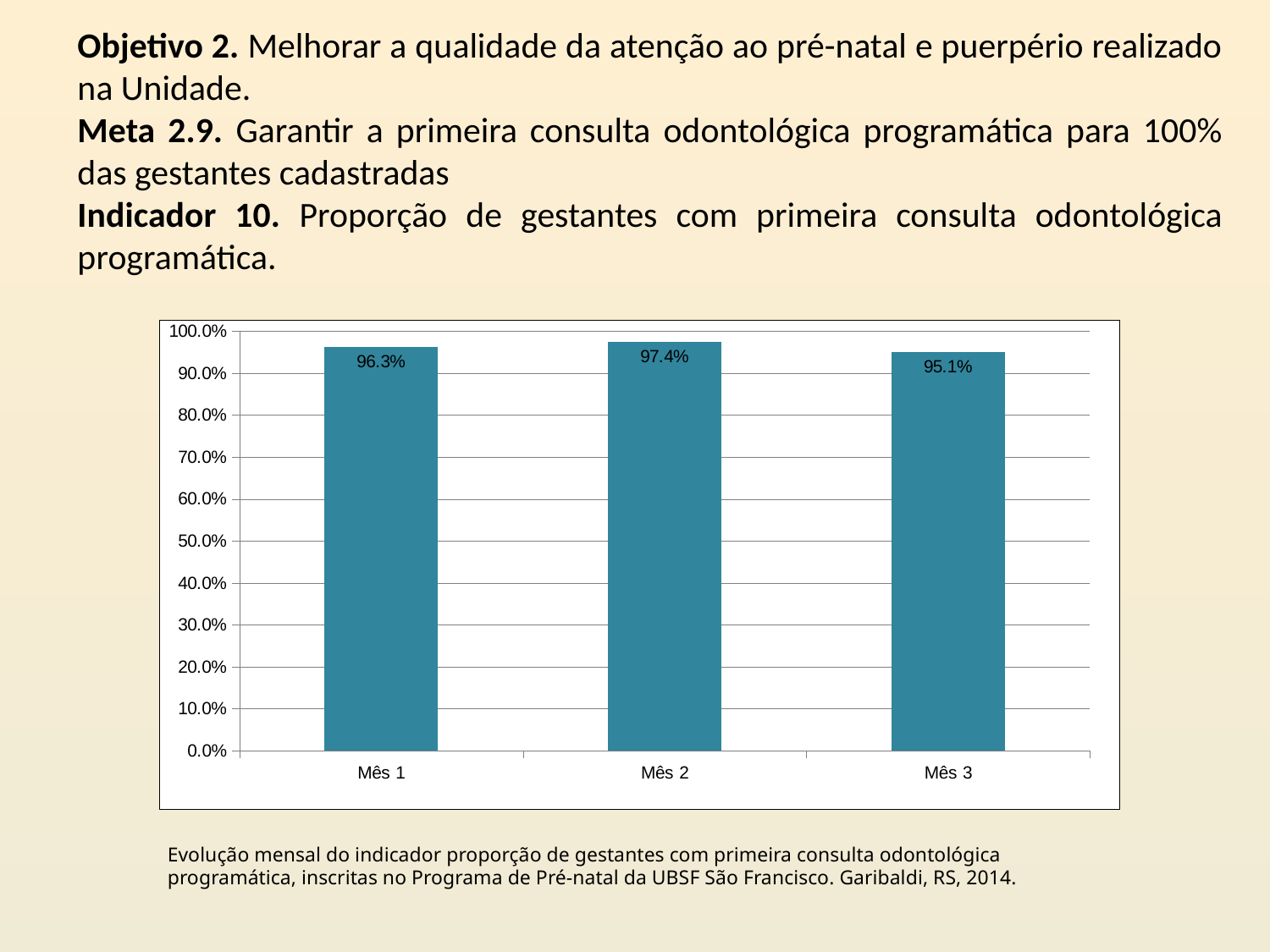
What is the value for Mês 3? 95.1% Which is larger, the value for Mês 1 or the value for Mês 3? Mês 1 What is the difference between the values for Mês 2 and Mês 3? 2.3% What kind of chart is shown on the slide? bar chart What is the highest value shown on the y axis? 100.0% What is the value for Mês 1? 96.3% Which month has the highest value? Mês 2 Is the value for Mês 3 greater or less than 90.0%? greater What is the difference between the values for Mês 2 and Mês 1? 1.1% How many months are shown on the x axis? 3 What is the value for Mês 2? 97.4% Which month has the lowest value? Mês 3